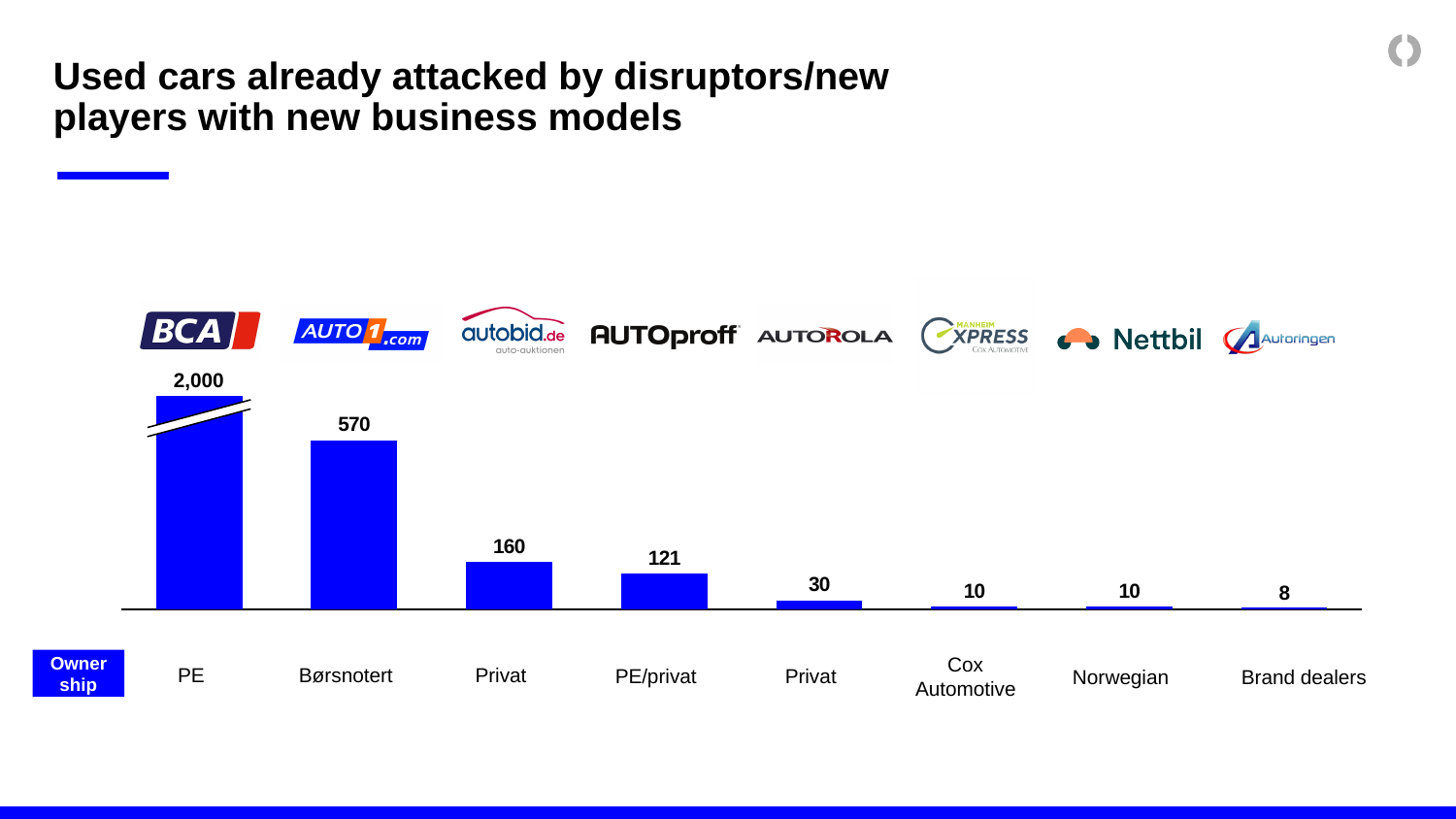
What kind of chart is shown on the slide? Bar chart Which has a larger value, AUTOproff or AUTOROLA? AUTOproff What value is shown for BCA? 2,000 Which company has the lowest value in the chart? Autoringen What value is shown for AUTOproff? 121 Which company has the highest value in the chart? BCA What value is shown for autobid.de? 160 What value is shown for Autoringen? 8 What value is shown for AUTO1.com? 570 What is the difference between the values for AUTO1.com and autobid.de? 410 What ownership type is listed under the BCA bar? PE How many bars are shown in the chart? 8